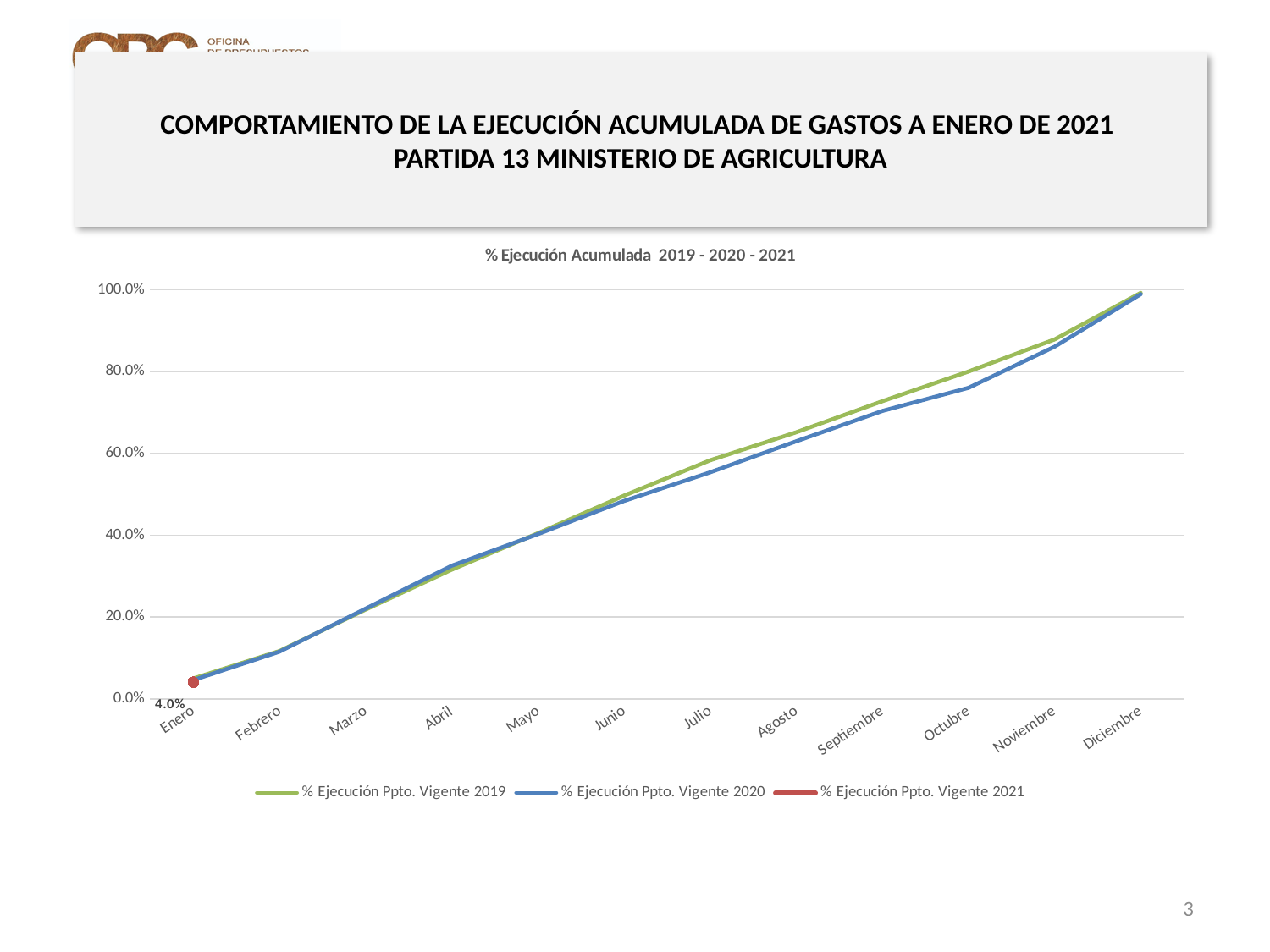
What is the value for % Ejecución Ppto. Vigente 2021 in Enero? 4.0% In Octubre, which series is higher: % Ejecución Ppto. Vigente 2019 or % Ejecución Ppto. Vigente 2020? % Ejecución Ppto. Vigente 2019 Is the value for % Ejecución Ppto. Vigente 2020 in Abril greater or less than 40.0%? less Is the value for % Ejecución Ppto. Vigente 2020 in Julio greater or less than 60.0%? less Do the values for % Ejecución Ppto. Vigente 2020 rise or fall from Enero to Diciembre? rise How many months are shown on the x axis? 12 Is the value for % Ejecución Ppto. Vigente 2019 in Diciembre greater or less than 80.0%? greater How many series does the legend list? 3 What is the title of the chart? % Ejecución Acumulada 2019 - 2020 - 2021 Which month has the highest value for % Ejecución Ppto. Vigente 2020? Diciembre What kind of chart is shown on the slide? line chart